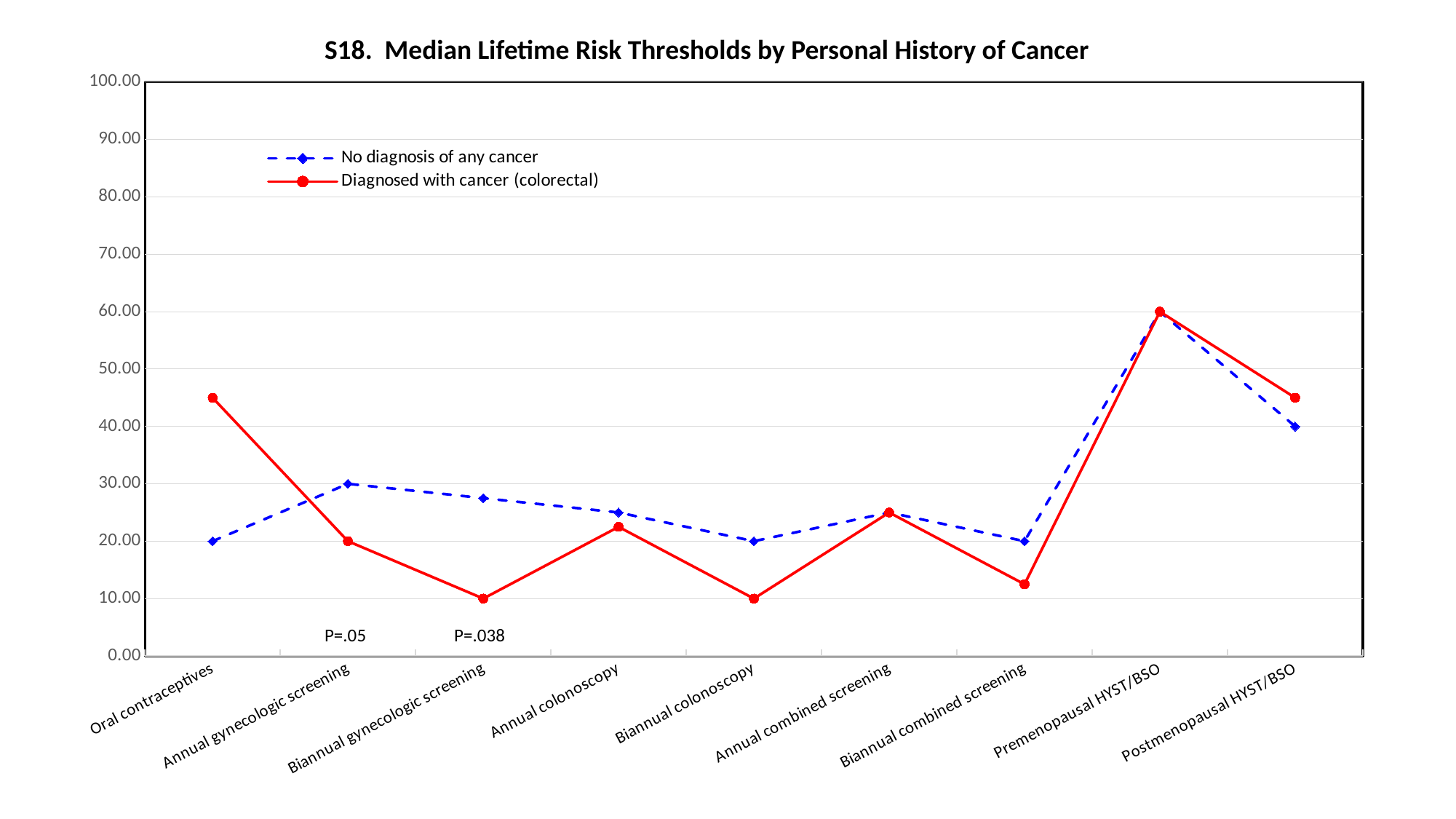
For Biannual combined screening, which series has the larger value: 'No diagnosis of any cancer' or 'Diagnosed with cancer (colorectal)'? No diagnosis of any cancer How many series does the legend list? 2 What is the value for Premenopausal HYST/BSO in the 'Diagnosed with cancer (colorectal)' series? 60.00 What is the title of the chart? S18. Median Lifetime Risk Thresholds by Personal History of Cancer What is the value for Biannual gynecologic screening in the 'Diagnosed with cancer (colorectal)' series? 10.00 What is the value for Annual gynecologic screening in the 'No diagnosis of any cancer' series? 30.00 What is the difference between the 'No diagnosis of any cancer' and 'Diagnosed with cancer (colorectal)' values for Annual gynecologic screening? 10.00 What kind of chart is shown on the slide? line chart What is the value for Oral contraceptives in the 'No diagnosis of any cancer' series? 20.00 Which category has the highest value in the 'No diagnosis of any cancer' series? Premenopausal HYST/BSO Is the value for Oral contraceptives in the 'Diagnosed with cancer (colorectal)' series greater or less than 40.00? greater How many categories are shown on the x axis? 9